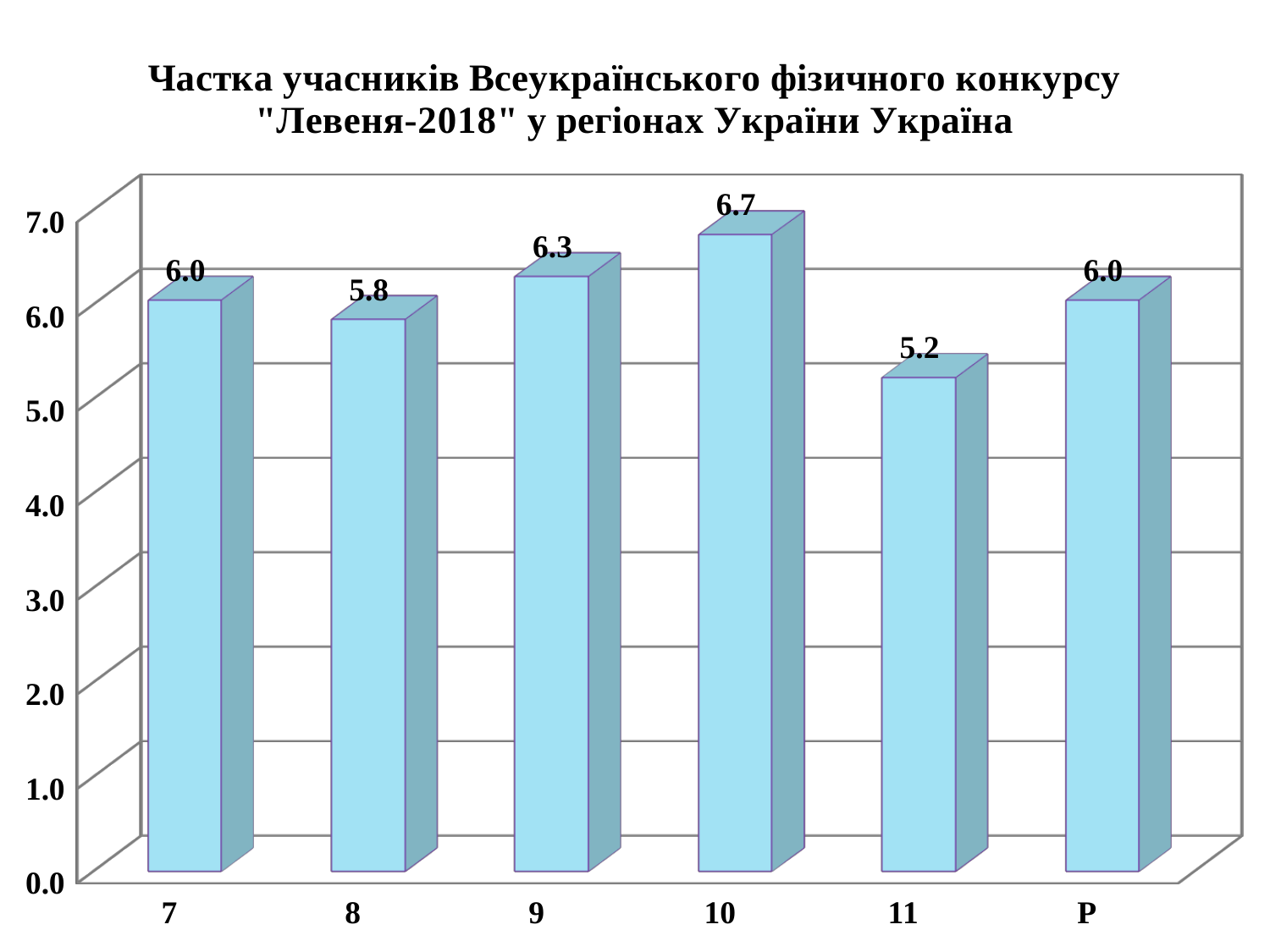
What is the difference between the values for category 9 and category 8? 0.5 What is the value for category Р? 6.0 What is the value for category 8? 5.8 How many categories are shown on the x axis? 6 Which category has the lowest value? 11 Is the value for category 11 greater or less than 6.0? less Which category has the highest value? 10 What is the difference between the values for category 10 and category 11? 1.5 Which is larger, the value for category 9 or the value for category 7? 9 What kind of chart is shown on the slide? bar chart What is the value for category 11? 5.2 What is the value for category 10? 6.7